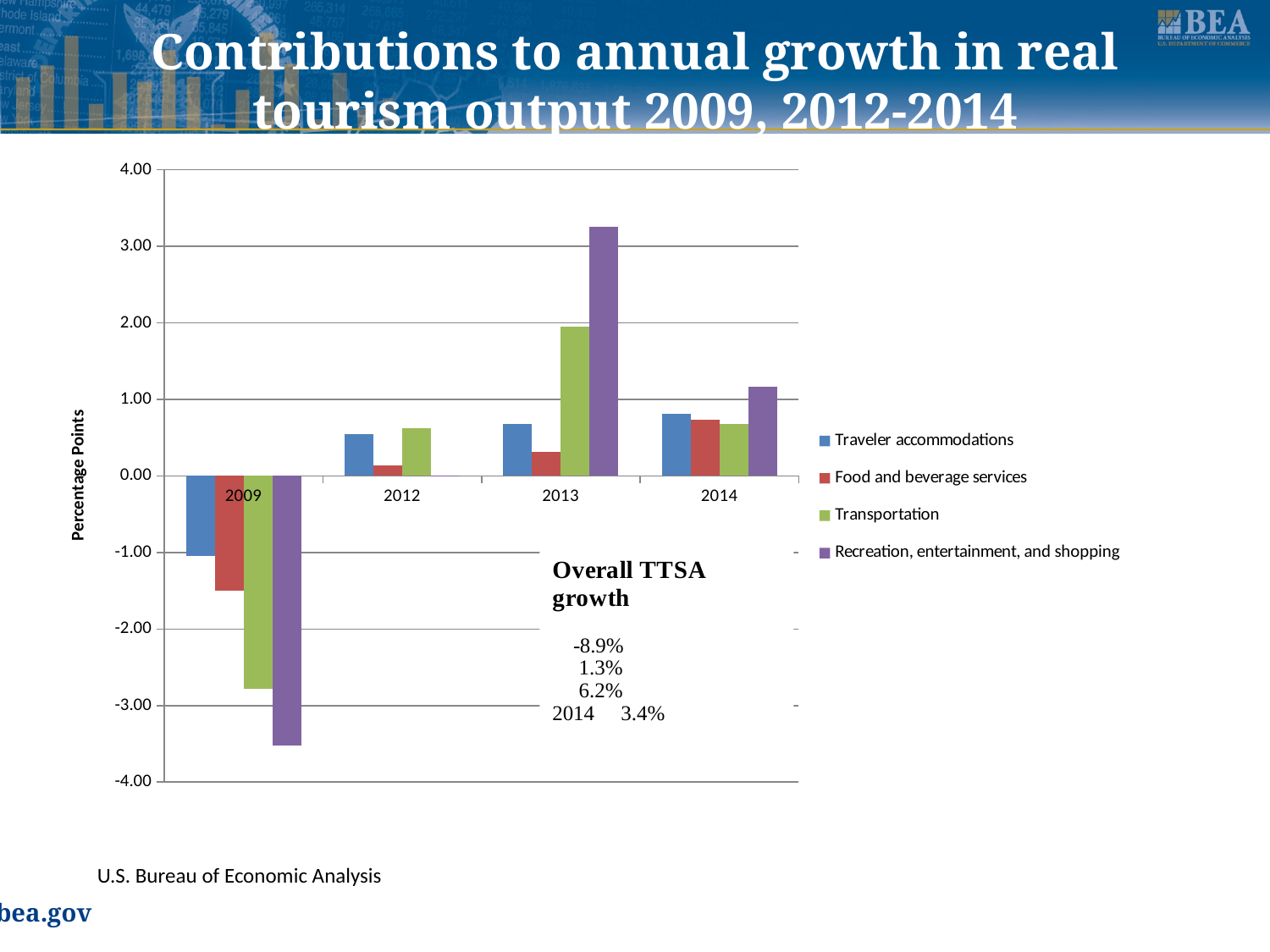
How many years are shown on the x axis of the chart? 4 How many series does the chart's legend list? 4 What kind of chart is shown on the slide? bar chart Does the value for Traveler accommodations rise or fall from 2012 to 2014? rise Is the value for Recreation, entertainment, and shopping in 2014 greater or less than 1.00? greater Is the value for Transportation in 2009 greater or less than -2.00? less What is the label on the chart's vertical axis? Percentage Points In 2013, which is larger: Transportation or Traveler accommodations? Transportation Is the value for Food and beverage services in 2009 greater or less than -1.00? less Which series has the highest value in 2013? Recreation, entertainment, and shopping Which series has the lowest value in 2009? Recreation, entertainment, and shopping